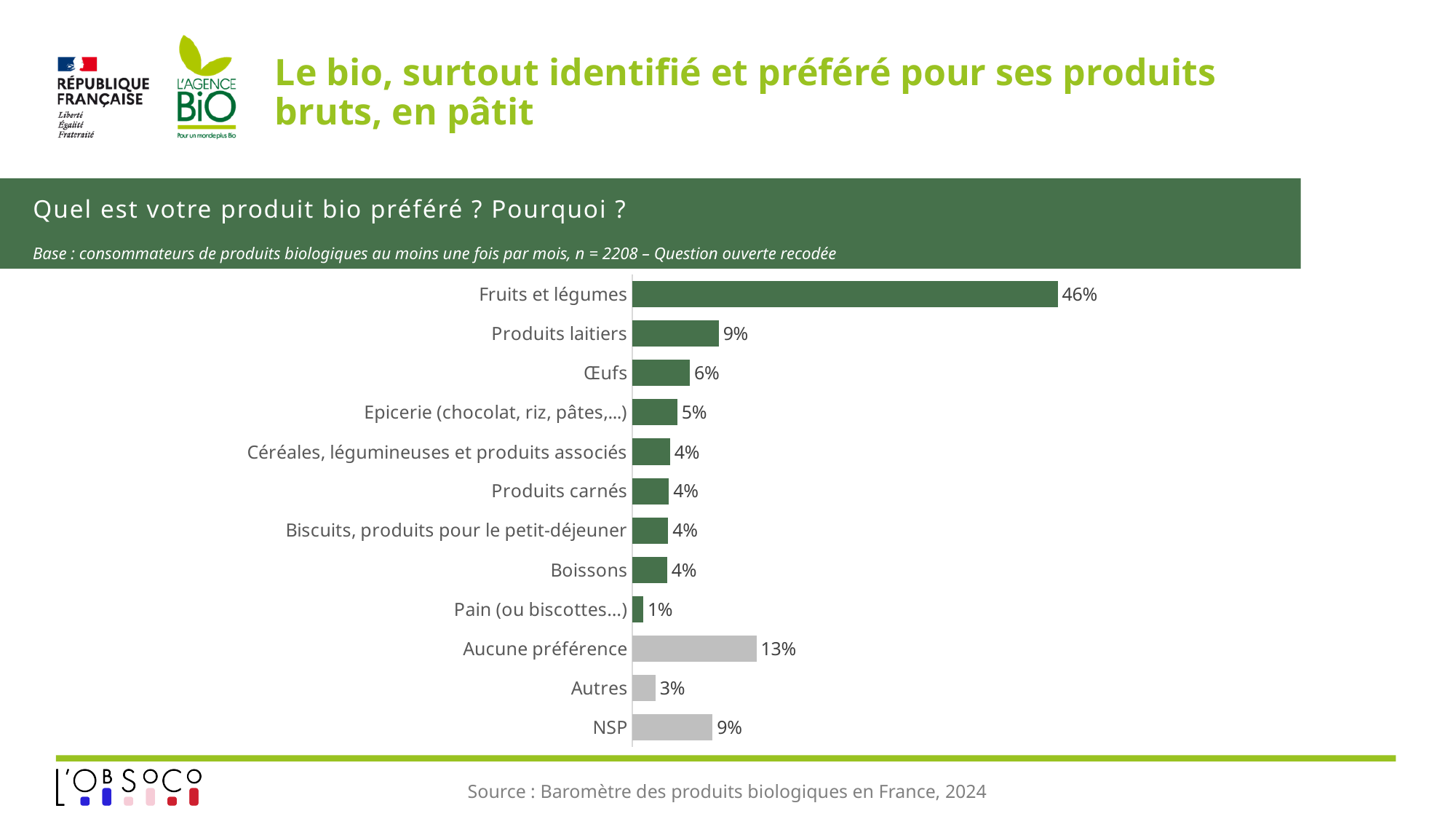
Which category has the highest value in the chart? Fruits et légumes How many categories are shown in the bar chart? 12 What is the value shown for Pain (ou biscottes...)? 1% What is the sample size (n) stated in the base description above the chart? 2208 What is the difference between the values for Aucune préférence and Autres? 10 percentage points What is the value shown for Produits laitiers? 9% What is the value shown for Aucune préférence? 13% What percentage of respondents named Fruits et légumes as their preferred organic product? 46% What is the difference between the values for Fruits et légumes and Produits laitiers? 37 percentage points Which is larger, the value for Œufs or the value for Epicerie (chocolat, riz, pâtes,...)? Œufs Which category has the lowest value in the chart? Pain (ou biscottes...) What type of chart is shown on the slide? Bar chart